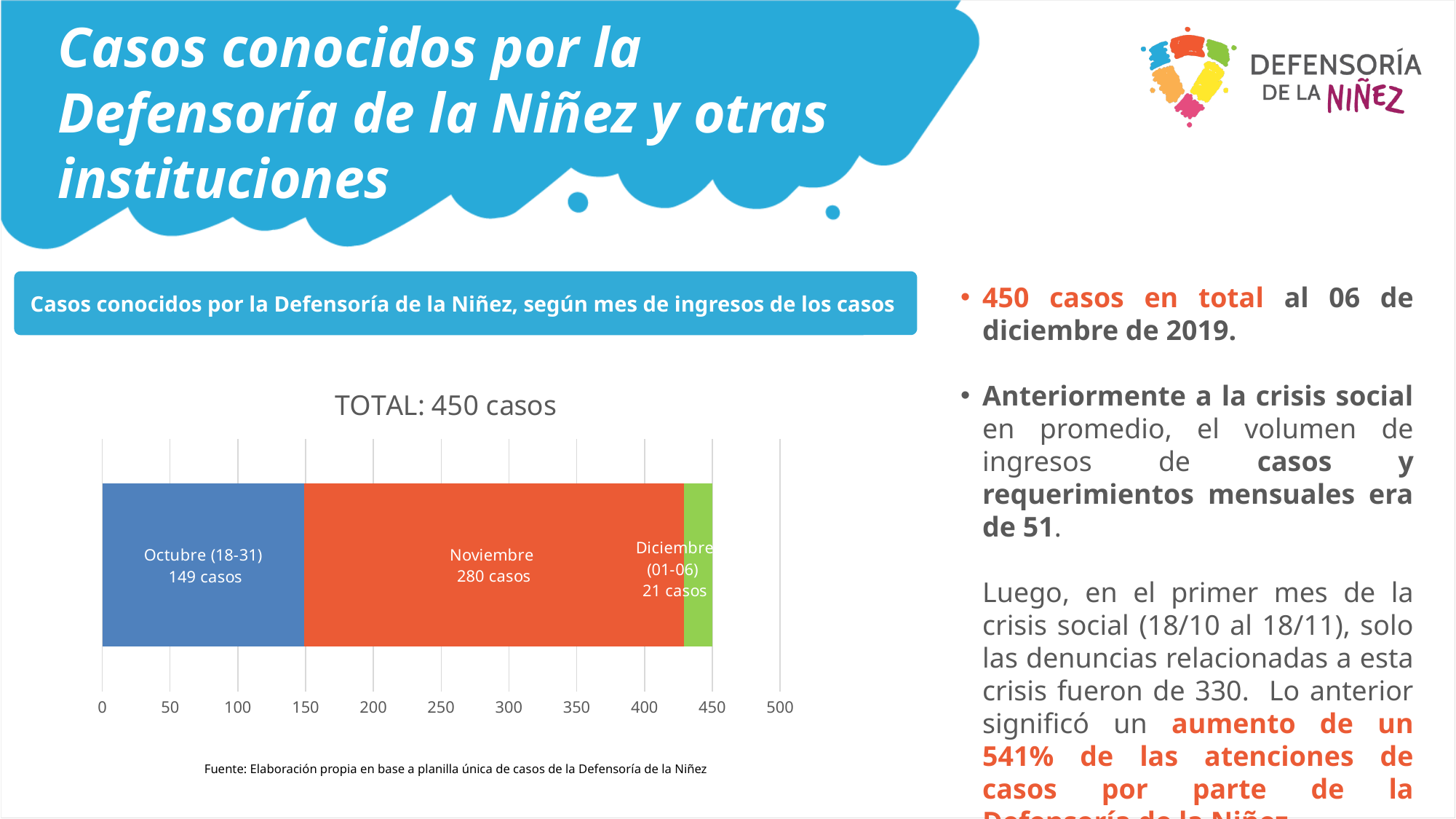
What kind of chart is shown on the slide? Stacked bar chart Which month segment has the highest number of cases? Noviembre How many month segments are shown in the stacked bar? 3 How many cases does the chart show for Octubre (18-31)? 149 casos Which month segment has the lowest number of cases? Diciembre (01-06) What is the total number of cases across all segments of the stacked bar? 450 casos What colour is the Noviembre segment of the bar? Orange What is the title shown above the chart? TOTAL: 450 casos How many cases does the chart show for Noviembre? 280 casos What is the difference in cases between Noviembre and Octubre (18-31)? 131 How many cases does the chart show for Diciembre (01-06)? 21 casos Which has more cases, Octubre (18-31) or Diciembre (01-06)? Octubre (18-31)